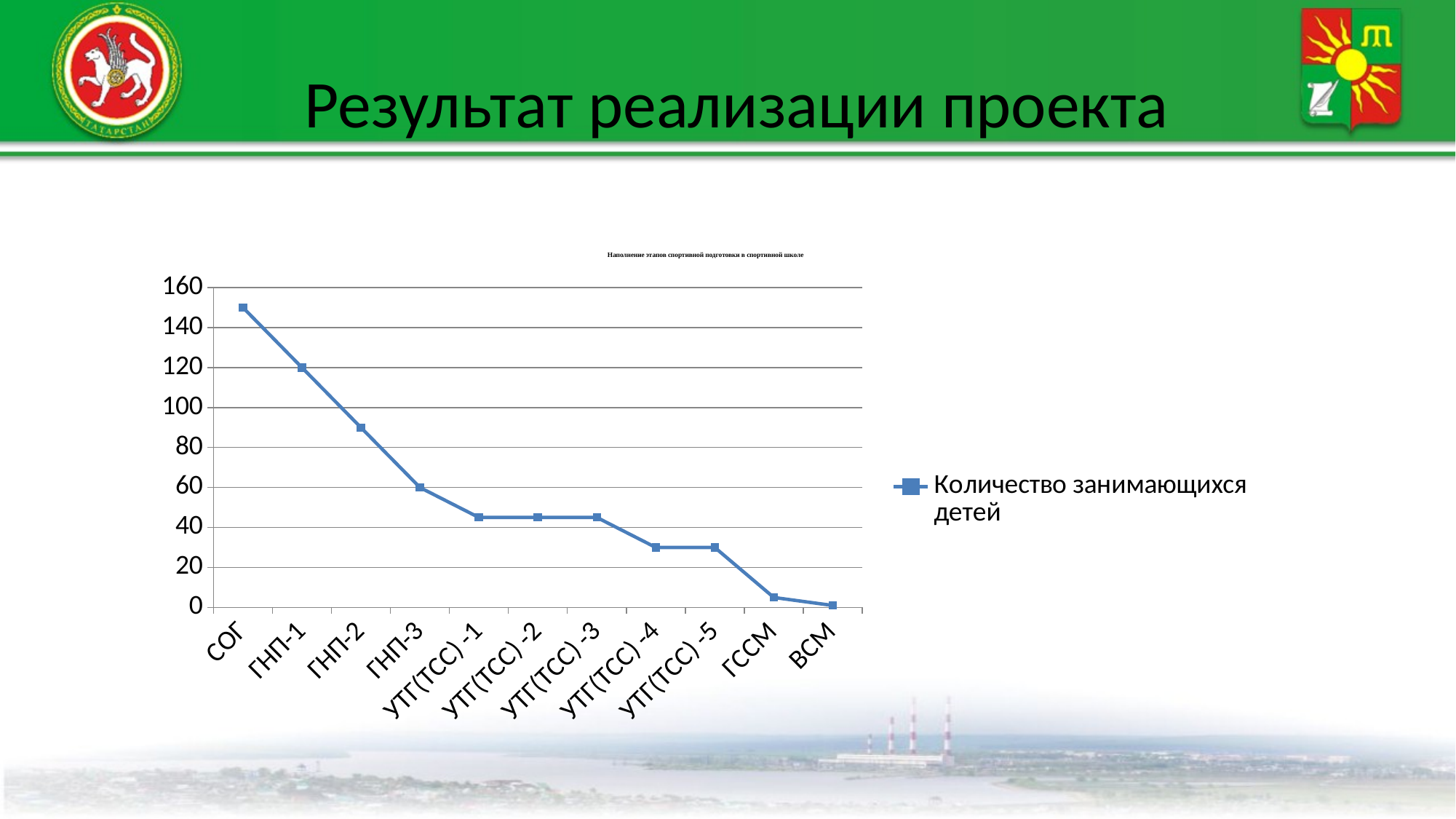
How many series does the legend list? 1 What kind of chart is shown on the slide? line chart How many categories are plotted along the x axis? 11 Is the value for СОГ greater or less than 140? greater What is the name of the series shown in the legend? Количество занимающихся детей Which category has the lowest value? ВСМ Is the value for УТГ(ТСС) -4 greater or less than 40? less What is the value for ГНП-1? 120 What is the value for ГНП-3? 60 Which category has the highest value? СОГ What is the difference between the values for ГНП-1 and ГНП-3? 60 Do the values rise or fall from СОГ to ВСМ along the x axis? fall